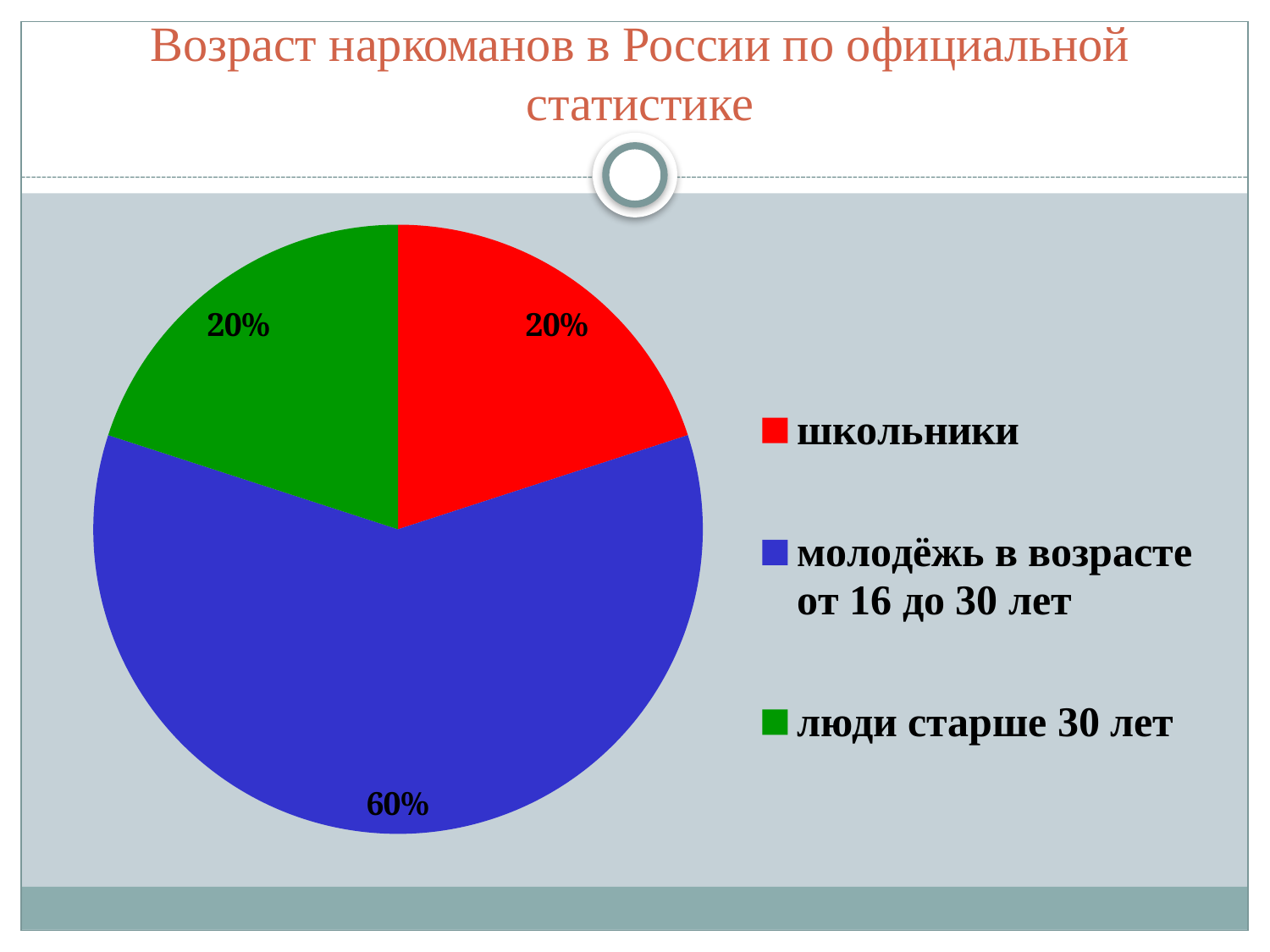
How many categories does the pie chart show? 3 What is the combined share of школьники and люди старше 30 лет? 40% Which is larger: the share for молодёжь в возрасте от 16 до 30 лет or the share for люди старше 30 лет? молодёжь в возрасте от 16 до 30 лет What is the difference between the share for молодёжь в возрасте от 16 до 30 лет and the share for школьники? 40% What colour is the slice for люди старше 30 лет? green What is the title of the chart? Возраст наркоманов в России по официальной статистике Which category has the largest slice of the pie? молодёжь в возрасте от 16 до 30 лет What kind of chart is shown on the slide? pie chart What share of the pie is labelled for люди старше 30 лет? 20% What share of the pie is labelled for молодёжь в возрасте от 16 до 30 лет? 60% What share of the pie is labelled for школьники? 20%